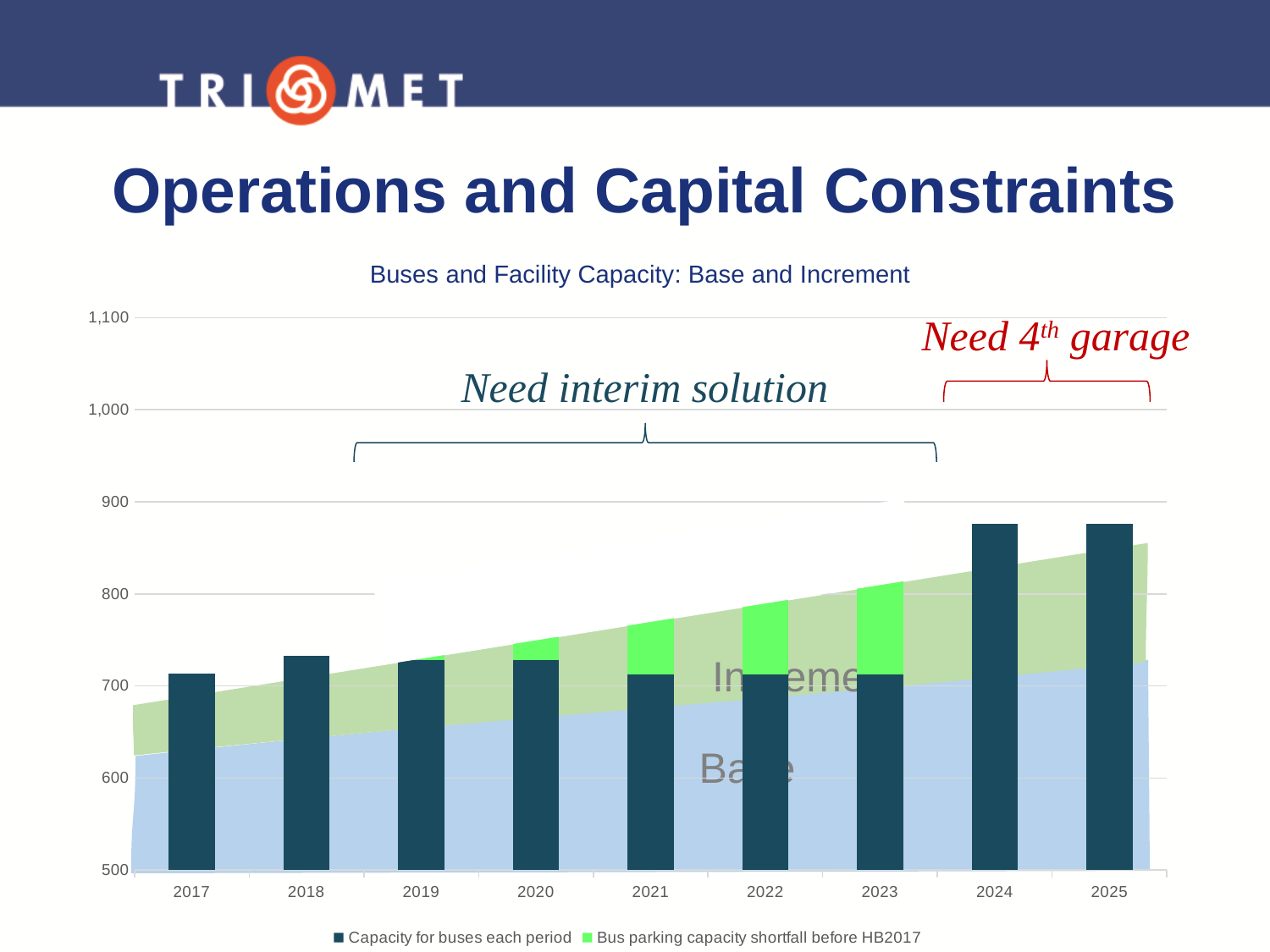
Does the upper edge of the shaded area (Base plus Increment) rise or fall from 2017 to 2025? rise Is the capacity for buses bar for 2024 greater or less than 800? greater Which year has the larger capacity for buses bar, 2017 or 2024? 2024 Which years have the highest bars for capacity for buses each period? 2024 and 2025 How many series does the legend list? 2 Is the capacity for buses bar for 2018 greater or less than 800? less What annotation is written in red above the 2024 and 2025 bars? Need 4th garage How many years are shown on the x axis of the chart? 9 Is the capacity for buses bar for 2017 greater or less than 600? greater What is the title of the chart? Buses and Facility Capacity: Base and Increment What kind of chart is used to show the capacity for buses each period? bar chart